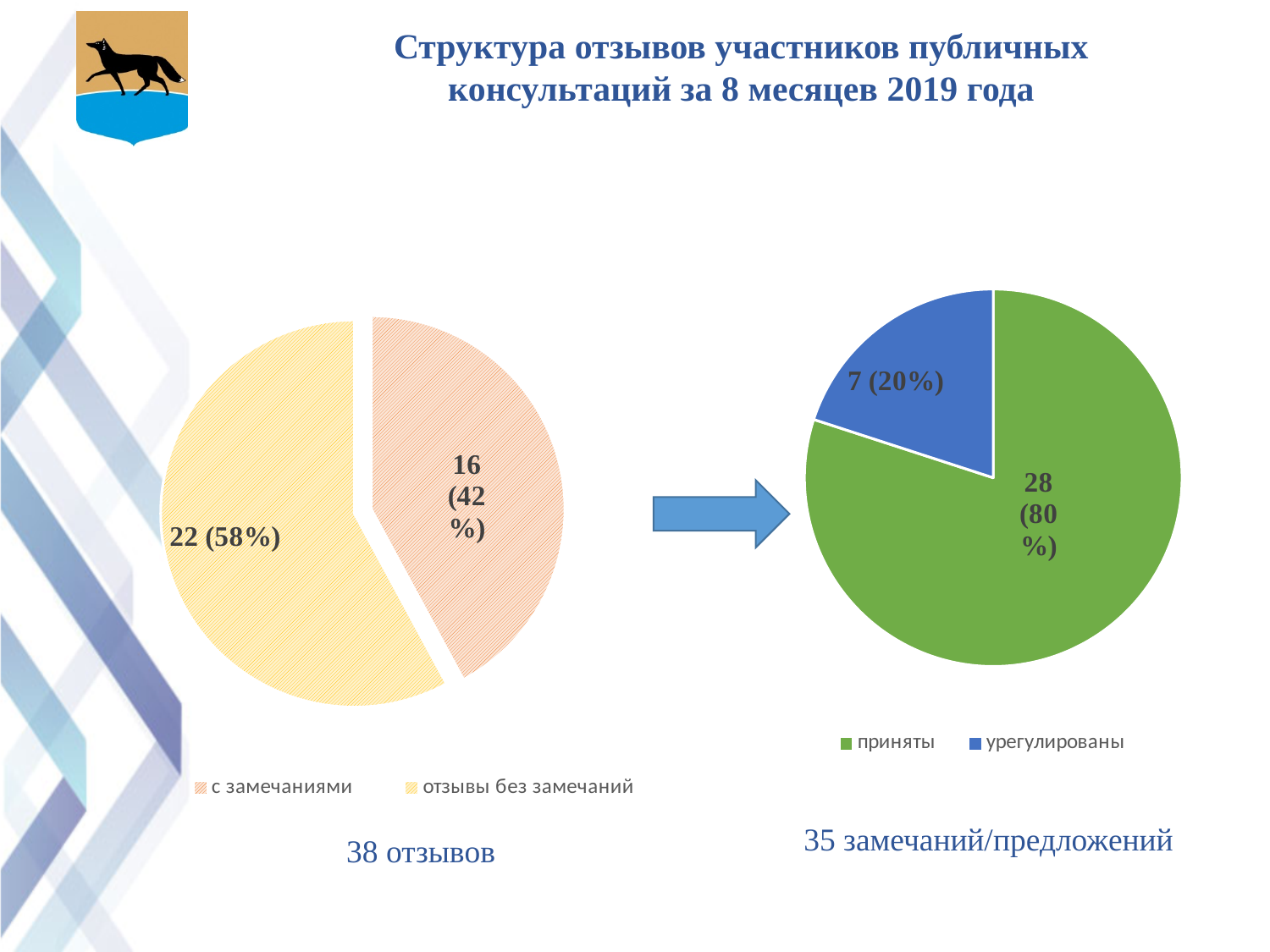
In the right pie chart, what value is shown for the slice 'урегулированы'? 7 (20%) In the left pie chart, what share of the pie does the 'с замечаниями' slice represent? 42% How many slices does the right pie chart have? 2 In the left pie chart, what is the difference between the number of reviews without remarks and the number with remarks? 6 In the left pie chart, what value is shown for the slice 'с замечаниями'? 16 (42%) In the right pie chart, what share of the pie does the 'приняты' slice represent? 80% In the right pie chart, what value is shown for the slice 'приняты'? 28 (80%) In the left pie chart, what value is shown for the slice 'отзывы без замечаний'? 22 (58%) What type of chart is shown on the left side of the slide? Pie chart In the right pie chart, which slice is the smallest? урегулированы In the right pie chart, what is the difference between the 'приняты' and 'урегулированы' values? 21 In the left pie chart, which slice is the largest? отзывы без замечаний